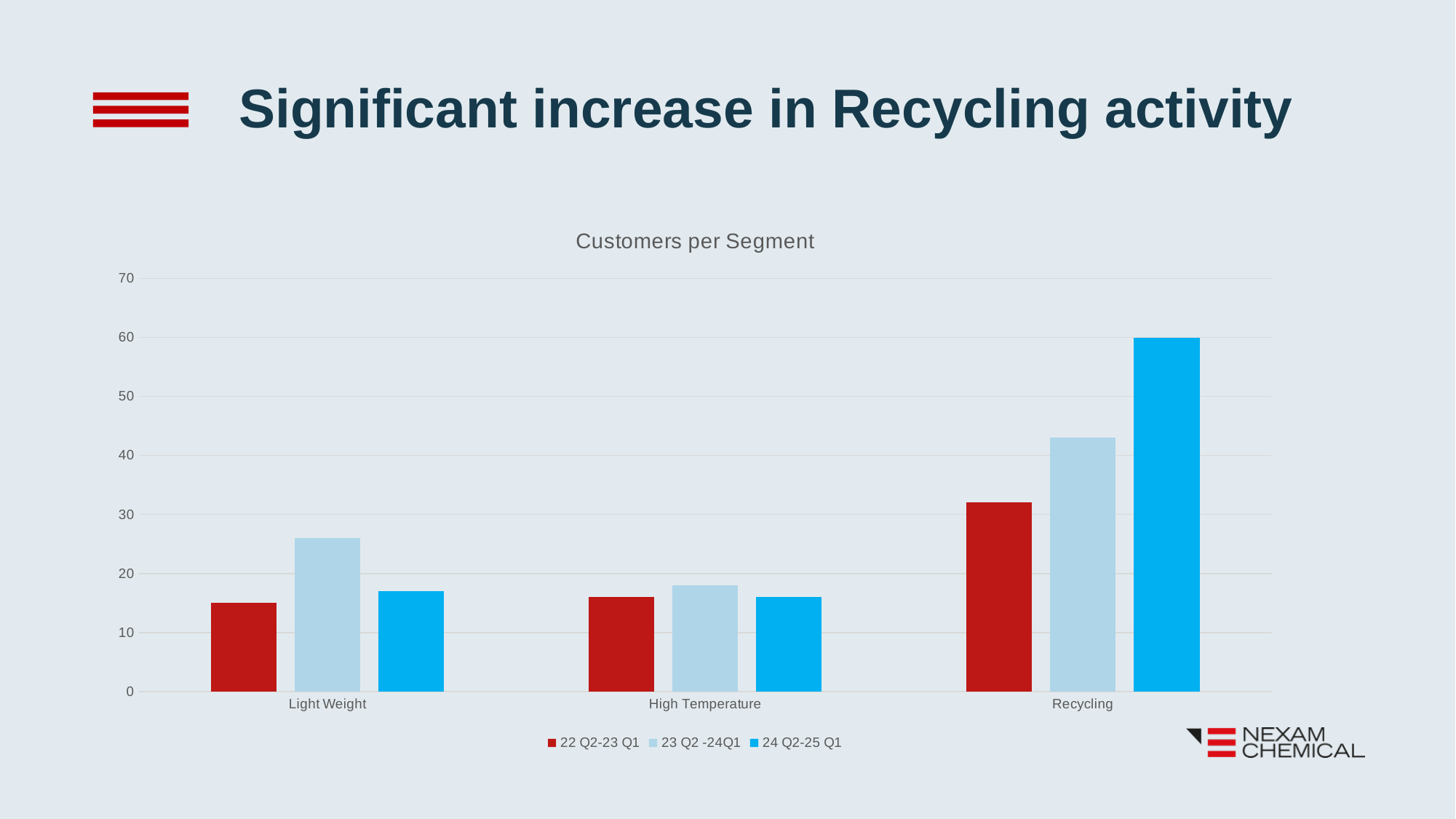
What is the value for Recycling in the 24 Q2-25 Q1 series? 60 Is the value for High Temperature in the 22 Q2-23 Q1 series greater or less than 20? less Is the value for Light Weight in the 23 Q2 -24Q1 series greater or less than 20? greater What kind of chart is shown on the slide? bar chart For Light Weight, which is larger: the 23 Q2 -24Q1 value or the 24 Q2-25 Q1 value? 23 Q2 -24Q1 How many segment categories are shown on the x axis? 3 How many series does the legend list? 3 Which segment has the highest value in the 24 Q2-25 Q1 series? Recycling What is the title of the chart? Customers per Segment Is the value for Recycling in the 23 Q2 -24Q1 series greater or less than 40? greater Which segment has the lowest value in the 23 Q2 -24Q1 series? High Temperature For Recycling, do the values rise or fall from the 22 Q2-23 Q1 series to the 24 Q2-25 Q1 series? rise